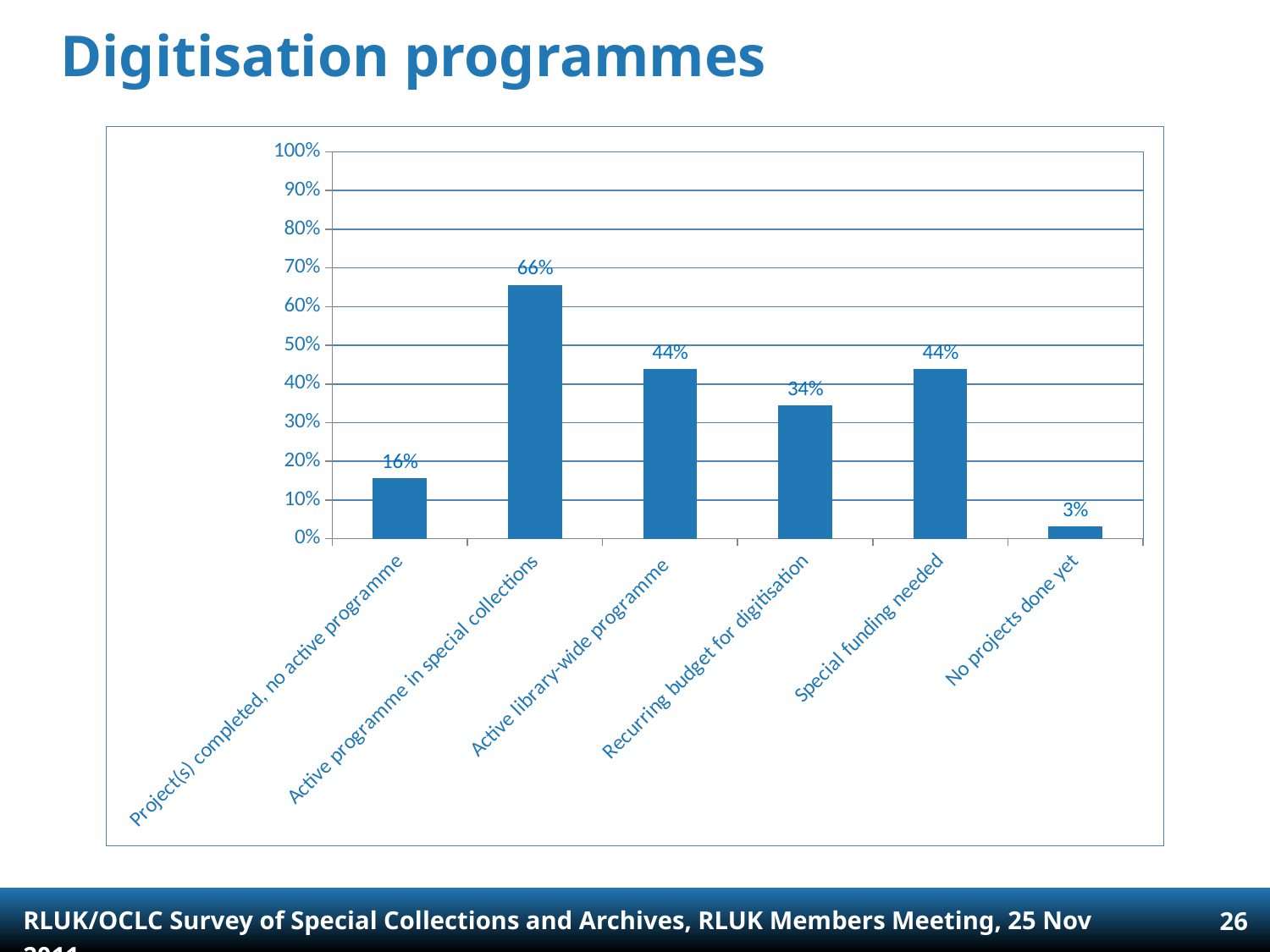
Which category has the lowest value? No projects done yet What is the value for "Active programme in special collections"? 66% Which category has the highest value? Active programme in special collections What is the value for "Project(s) completed, no active programme"? 16% What kind of chart is shown on the slide? Bar chart What is the value for "No projects done yet"? 3% What is the value for "Recurring budget for digitisation"? 34% Which is larger: "Recurring budget for digitisation" or "Special funding needed"? Special funding needed How many categories are shown on the x axis? 6 Is the value for "Recurring budget for digitisation" greater or less than 40%? less What is the difference between "Active programme in special collections" and "Active library-wide programme"? 22% What is the title of the slide containing the chart? Digitisation programmes